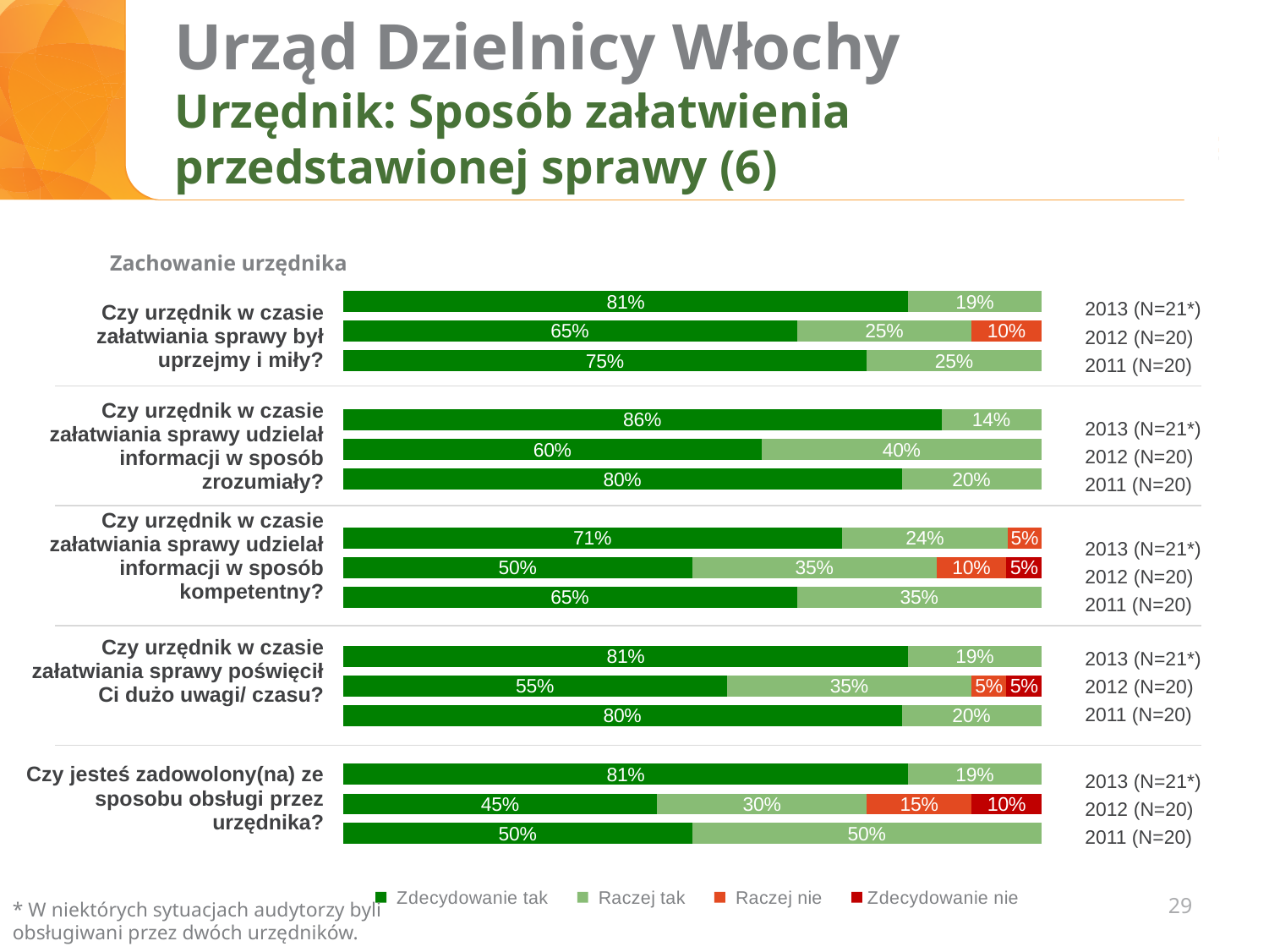
For "Czy urzędnik w czasie załatwiania sprawy udzielał informacji w sposób zrozumiały?", which year had the highest share of "Zdecydowanie tak"? 2013 For "Czy urzędnik w czasie załatwiania sprawy poświęcił Ci dużo uwagi/ czasu?", which year had a larger "Zdecydowanie tak" share, 2011 or 2012? 2011 What percentage answered "Raczej nie" in 2012 to "Czy jesteś zadowolony(na) ze sposobu obsługi przez urzędnika?"? 15% What kind of chart is shown on the slide? Stacked bar chart How many answer categories does the legend list? 4 What percentage answered "Zdecydowanie nie" in 2012 to "Czy jesteś zadowolony(na) ze sposobu obsługi przez urzędnika?"? 10% What percentage answered "Raczej tak" in 2012 to "Czy urzędnik w czasie załatwiania sprawy udzielał informacji w sposób zrozumiały?"? 40% What is the total of the 2013 bar for "Czy urzędnik w czasie załatwiania sprawy był uprzejmy i miły?" (81% plus 19%)? 100% What percentage answered "Zdecydowanie tak" in 2013 to "Czy urzędnik w czasie załatwiania sprawy był uprzejmy i miły?"? 81% For "Czy urzędnik w czasie załatwiania sprawy udzielał informacji w sposób kompetentny?", what is the difference in the "Zdecydowanie tak" share between 2013 and 2012? 21 percentage points How many survey questions are shown in the chart? 5 For "Czy jesteś zadowolony(na) ze sposobu obsługi przez urzędnika?", which year had the lowest share of "Zdecydowanie tak"? 2012